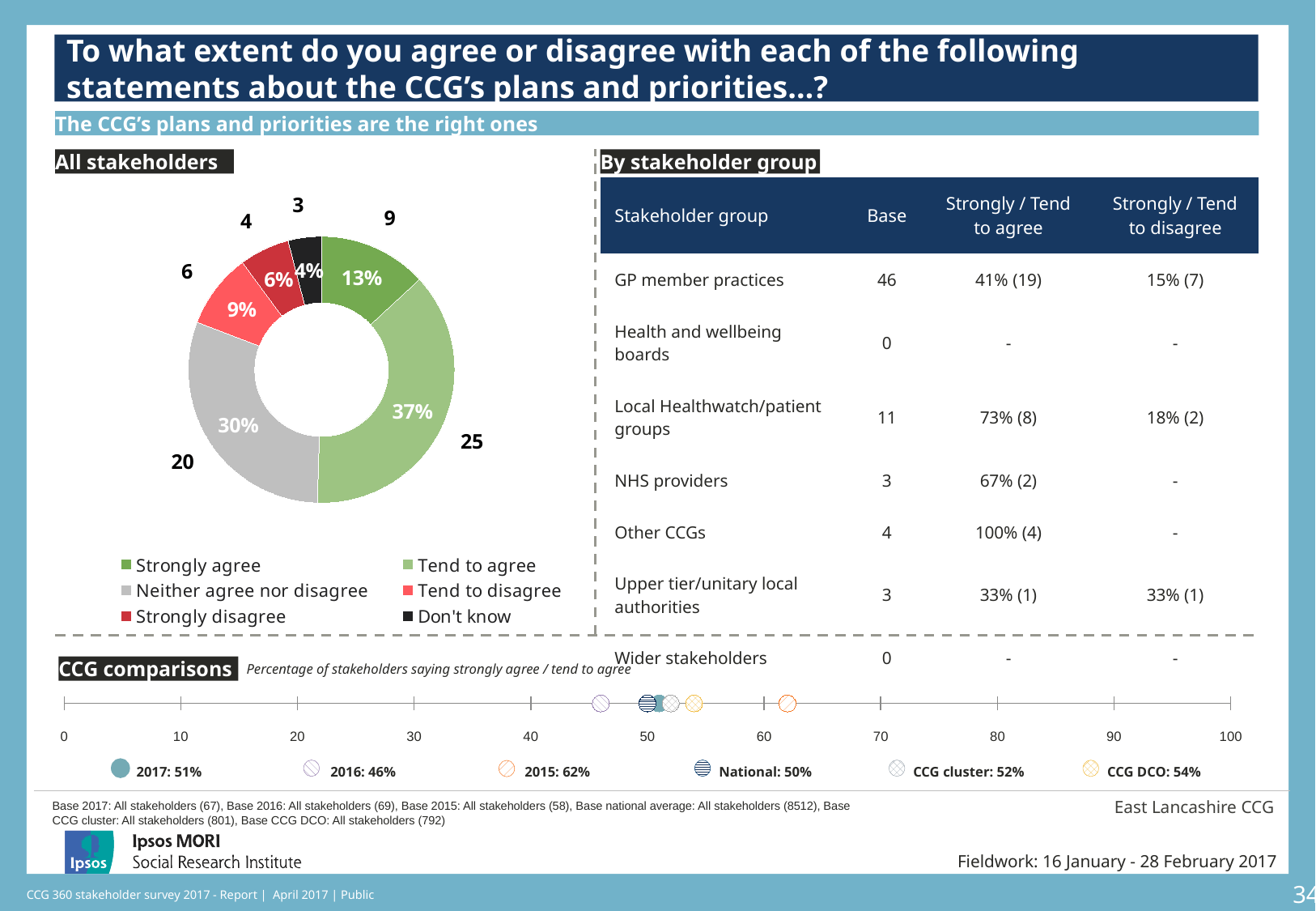
In the 'All stakeholders' chart, what is the difference in percentage points between 'Tend to agree' and 'Strongly agree'? 24 In the 'CCG comparisons' chart, what is the difference in percentage points between the 2017 value and the 2016 value? 5 In the 'All stakeholders' chart, which is larger: the share for 'Tend to disagree' or the share for 'Strongly disagree'? Tend to disagree In the 'All stakeholders' chart, what percentage of stakeholders neither agree nor disagree? 30% In the 'All stakeholders' chart, which response category has the largest share? Tend to agree In the 'All stakeholders' chart, what percentage of stakeholders tend to agree? 37% In the 'CCG comparisons' chart, which comparison point has the highest value? 2015: 62% In the 'All stakeholders' chart, which response category has the smallest share? Don't know How many response categories does the legend of the 'All stakeholders' chart list? 6 In the 'All stakeholders' chart, what percentage of stakeholders strongly disagree? 6% What type of chart is the 'All stakeholders' chart? Donut (pie) chart In the 'CCG comparisons' chart, what percentage of stakeholders said strongly agree / tend to agree in 2017? 51%